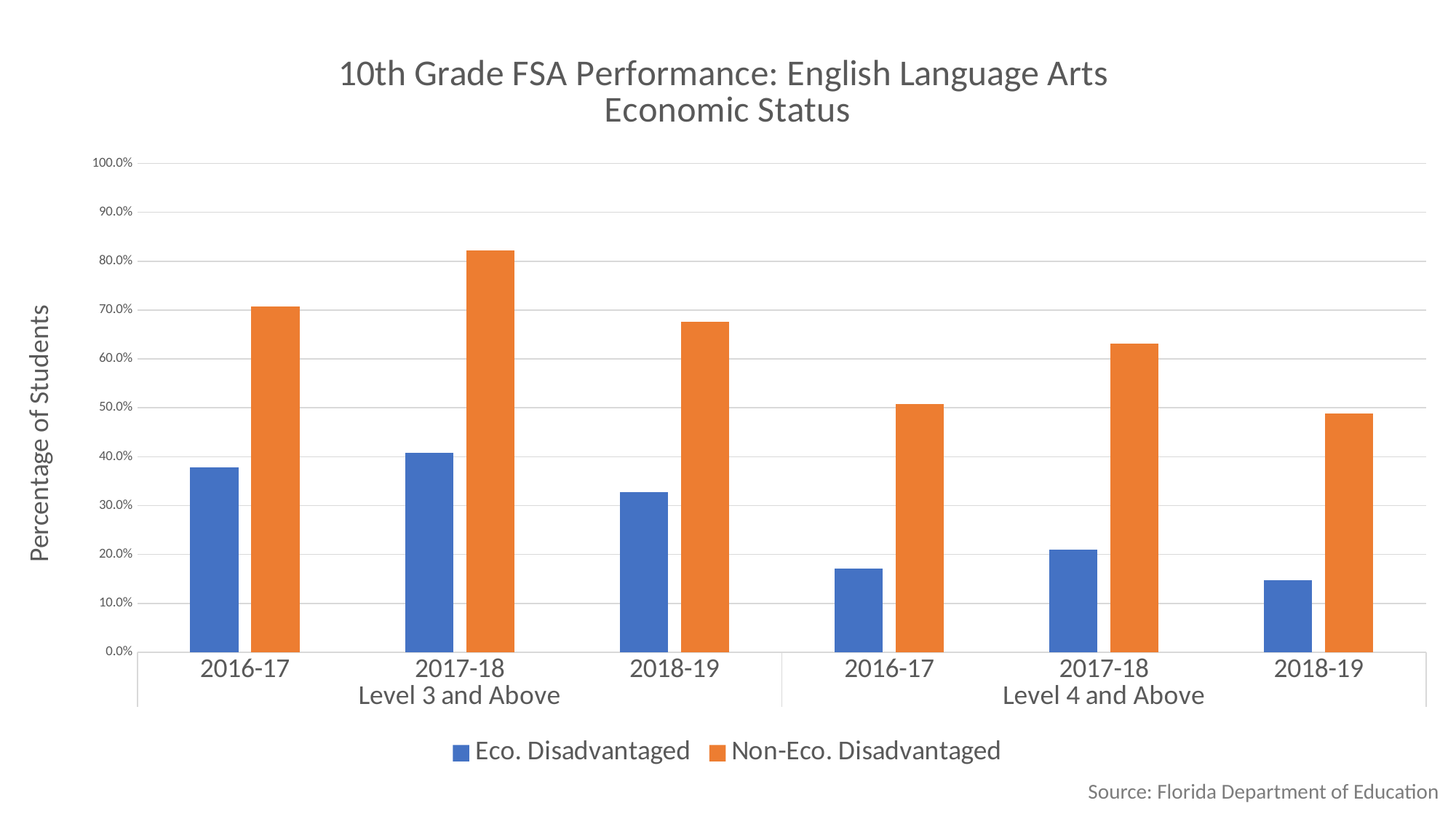
How many year categories are plotted along the x axis in total? 6 Under Level 4 and Above, does the Non-Eco. Disadvantaged value rise or fall from 2017-18 to 2018-19? fall Which year and level has the lowest Eco. Disadvantaged bar? 2018-19, Level 4 and Above Is the Non-Eco. Disadvantaged value for 2017-18 under Level 3 and Above greater or less than 70.0%? greater Is the Eco. Disadvantaged value for 2018-19 under Level 4 and Above greater or less than 20.0%? less Is the Eco. Disadvantaged value for 2016-17 under Level 3 and Above greater or less than 40.0%? less Which year and level has the highest Non-Eco. Disadvantaged bar? 2017-18, Level 3 and Above How many series does the legend list? 2 Under Level 3 and Above, which is larger: the Eco. Disadvantaged value for 2017-18 or for 2018-19? 2017-18 What kind of chart is shown on the slide? bar chart What is the label on the vertical axis? Percentage of Students